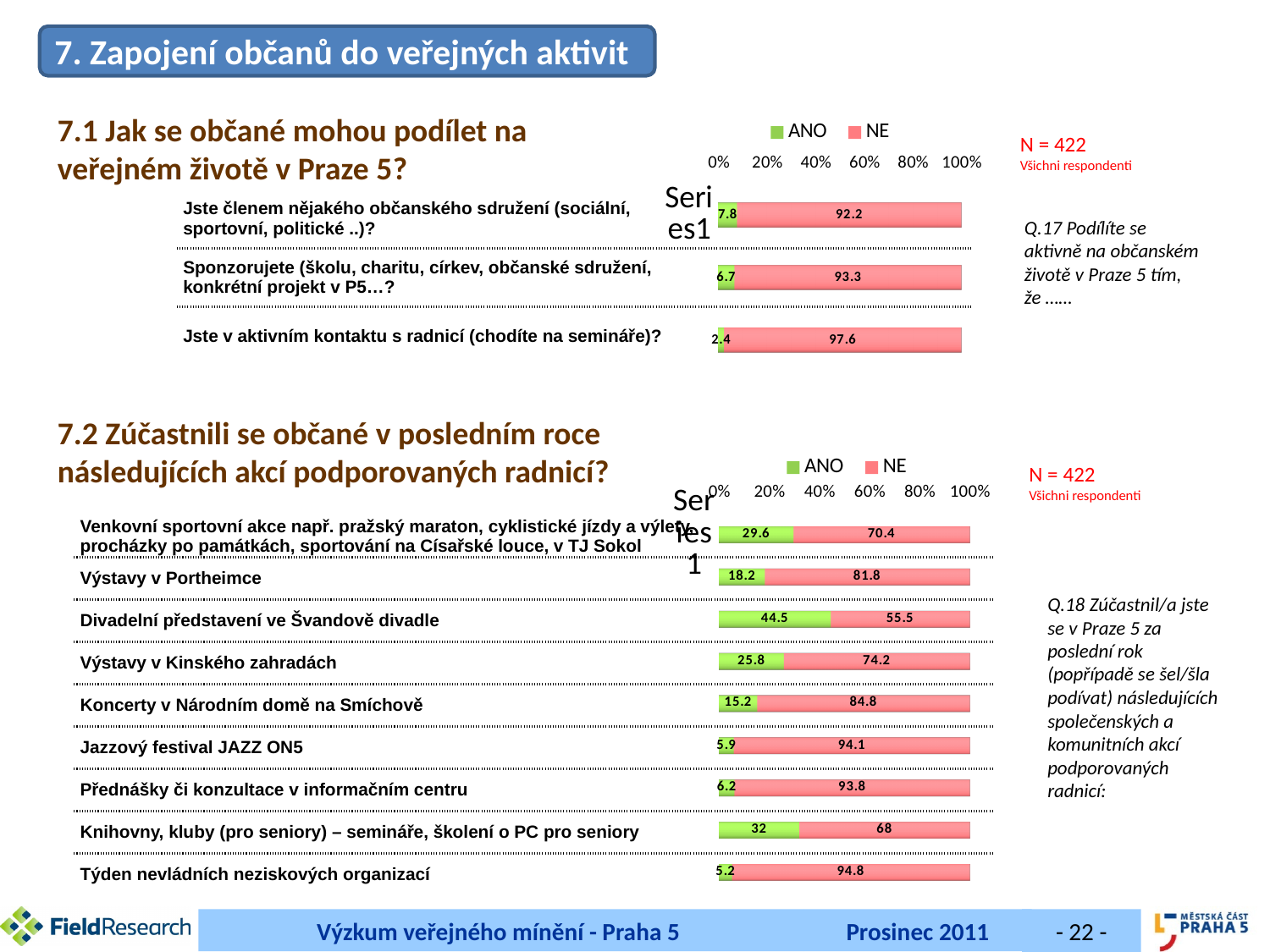
In the top chart (7.1), which category has the lowest ANO value? Jste v aktivním kontaktu s radnicí (chodíte na semináře)? In the top chart (7.1), what is the NE value for "Jste v aktivním kontaktu s radnicí (chodíte na semináře)?"? 97.6 How many series does the legend of the bottom chart (7.2) list? 2 In the bottom chart (7.2), how many categories are shown? 9 In the bottom chart (7.2), what is the difference between the ANO values for "Venkovní sportovní akce" and "Výstavy v Kinského zahradách"? 3.8 In the top chart (7.1), how many categories are shown? 3 In the bottom chart (7.2), what is the ANO value for "Divadelní představení ve Švandově divadle"? 44.5 In the bottom chart (7.2), which has a larger ANO value: "Výstavy v Portheimce" or "Koncerty v Národním domě na Smíchově"? Výstavy v Portheimce In the top chart (7.1), what is the ANO value for "Jste členem nějakého občanského sdružení (sociální, sportovní, politické ..)?"? 7.8 In the bottom chart (7.2), which category has the lowest ANO value? Týden nevládních neziskových organizací In the bottom chart (7.2), what is the NE value for "Knihovny, kluby (pro seniory) – semináře, školení o PC pro seniory"? 68 In the bottom chart (7.2), which category has the highest ANO value? Divadelní představení ve Švandově divadle